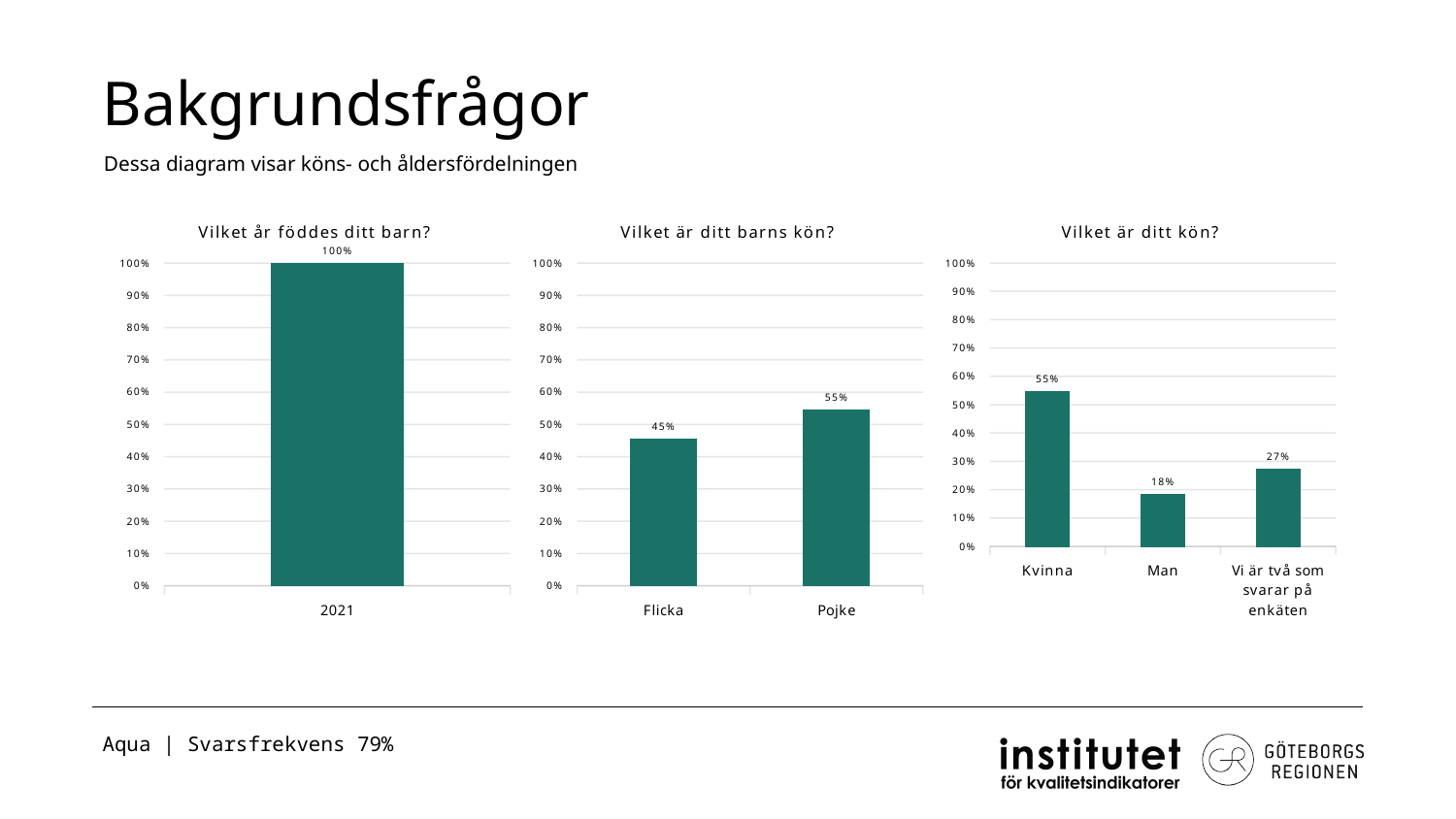
In the chart 'Vilket är ditt kön?', what is the difference between Kvinna and Man? 37% In the chart 'Vilket är ditt barns kön?', what is the difference between Pojke and Flicka? 10% In the chart 'Vilket är ditt barns kön?', which category has the higher value? Pojke In the chart 'Vilket är ditt kön?', what is the value for Man? 18% In the chart 'Vilket är ditt kön?', which category has the lowest value? Man What type of chart is 'Vilket är ditt barns kön?'? Bar chart In the chart 'Vilket är ditt kön?', what is the value for Kvinna? 55% In the chart 'Vilket är ditt barns kön?', what is the value for Pojke? 55% In the chart 'Vilket är ditt barns kön?', what is the value for Flicka? 45% In the chart 'Vilket år föddes ditt barn?', what is the value for 2021? 100% How many categories are shown in the chart 'Vilket är ditt kön?'? 3 In the chart 'Vilket är ditt kön?', what is the value for 'Vi är två som svarar på enkäten'? 27%